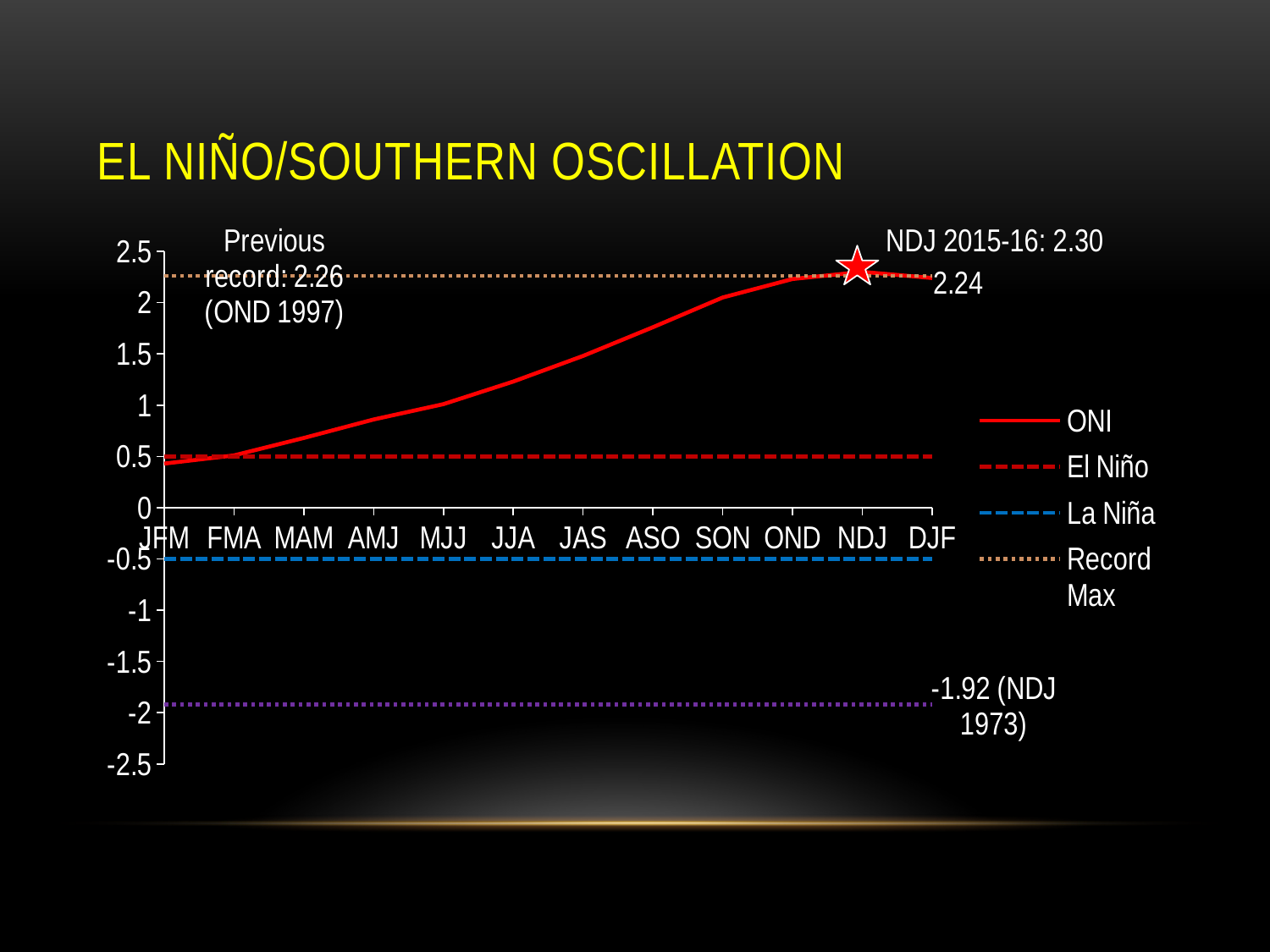
What is the ONI value labelled at DJF? 2.24 Is the ONI value for MJJ greater or less than 0.5? greater How many series does the legend list? 4 Does the ONI line rise or fall from JFM to NDJ? rises What kind of chart is shown on the slide? line chart What is the previous record ONI value shown on the chart? 2.26 How many three-month periods are shown along the x axis? 12 What is the difference between the NDJ 2015-16 value and the DJF value? 0.06 What is the ONI value labelled for NDJ 2015-16? 2.30 In which period does the ONI line reach its highest value? NDJ What is the title of the slide? EL NIÑO/SOUTHERN OSCILLATION In which period is the ONI line at its lowest value? JFM